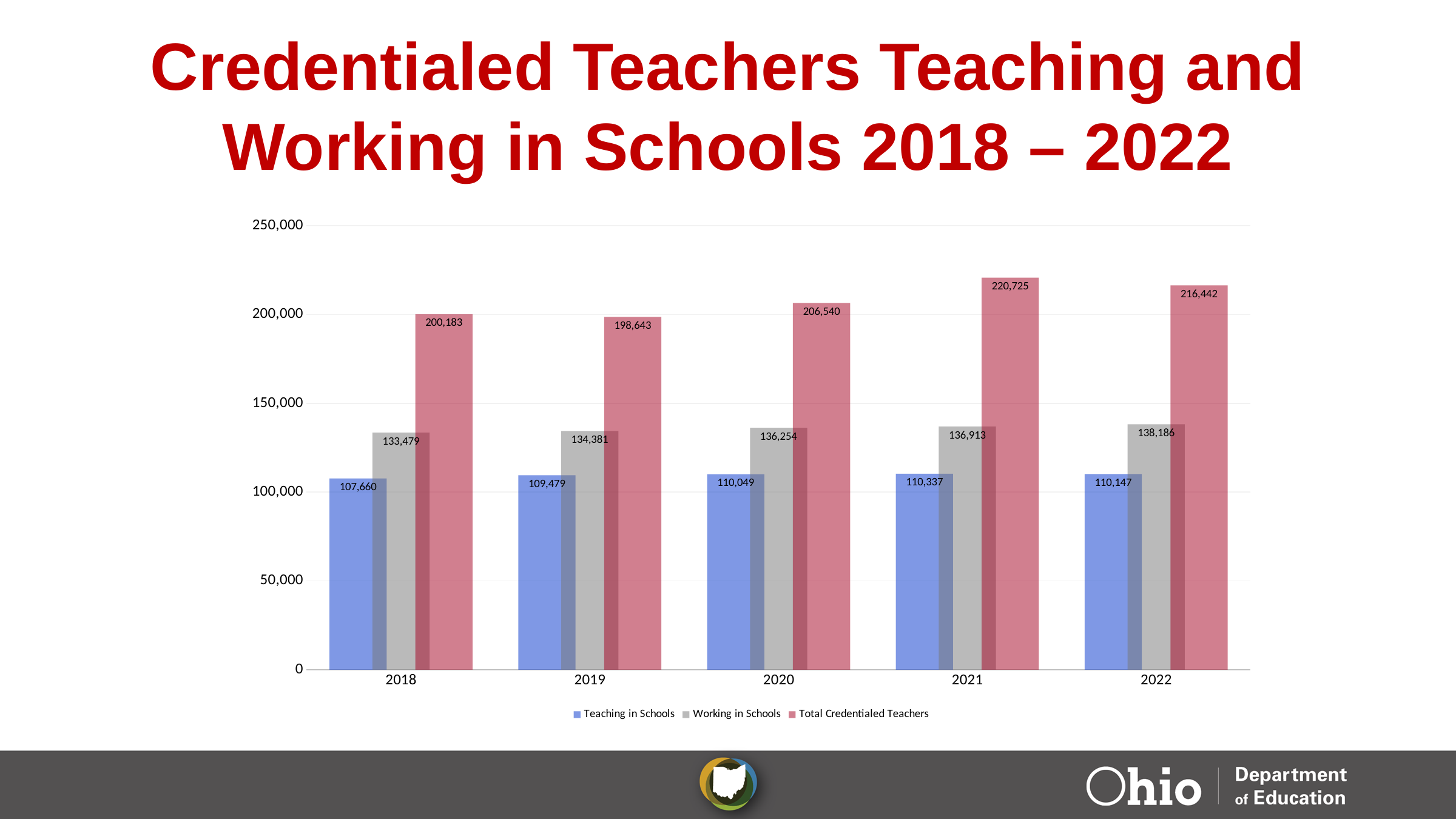
In which year is Total Credentialed Teachers lowest? 2019 What is the value for Teaching in Schools in 2018? 107,660 What is the difference between Total Credentialed Teachers and Working in Schools in 2021? 83,812 Does the Working in Schools series rise or fall from 2018 to 2022? Rise What kind of chart is shown on the slide? Bar chart What is the value for Total Credentialed Teachers in 2020? 206,540 How many series does the legend list? 3 What is the value for Working in Schools in 2022? 138,186 How many years are shown on the x axis? 5 In which year is Teaching in Schools lowest? 2018 In which year is Total Credentialed Teachers highest? 2021 Which is larger: Total Credentialed Teachers in 2022 or Total Credentialed Teachers in 2020? Total Credentialed Teachers in 2022